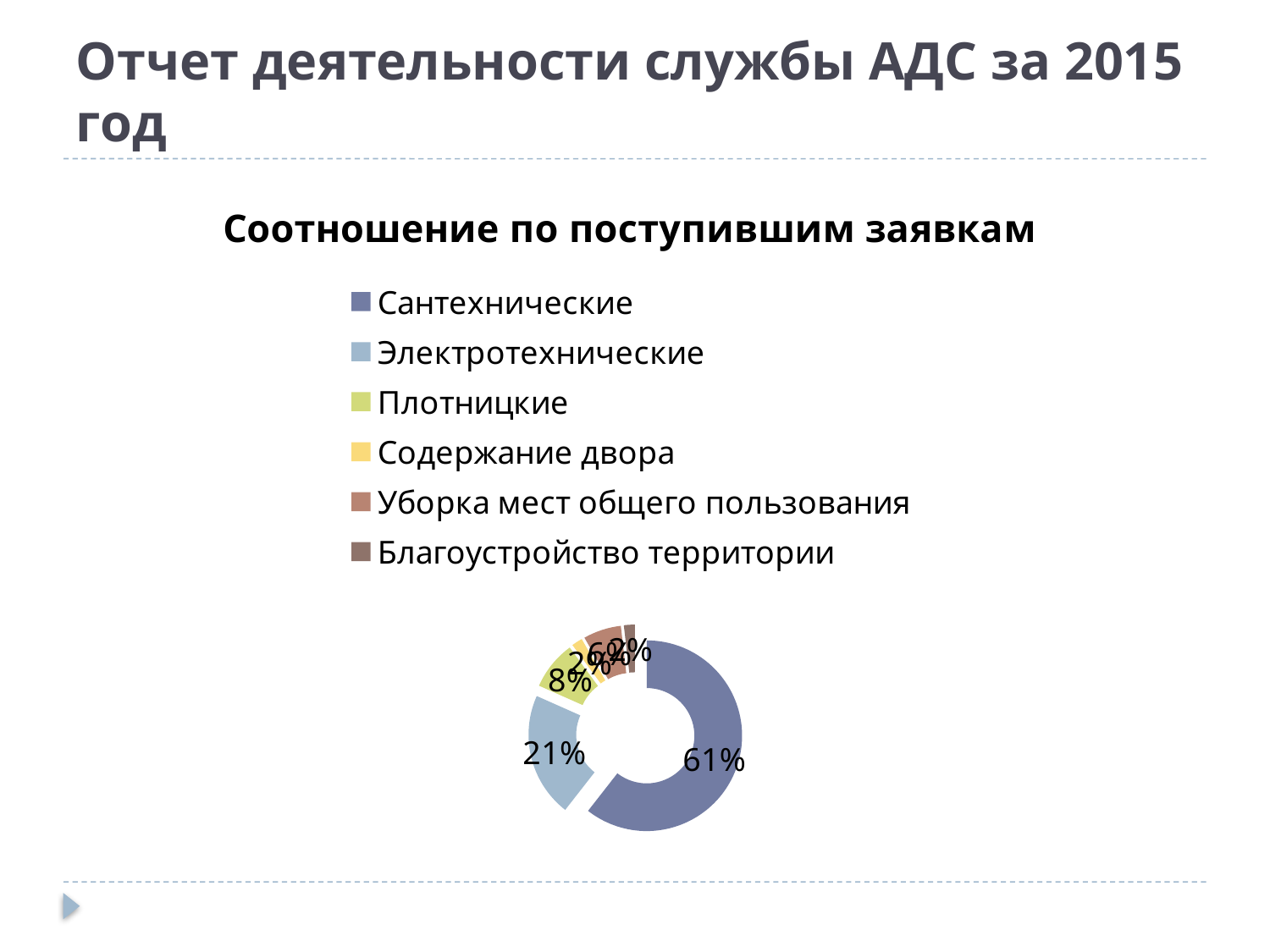
What share of the chart is Сантехнические? 61% Which is larger, the share for Плотницкие or for Электротехнические? Электротехнические What is the difference in percentage points between the shares for Электротехнические and Плотницкие? 13 What is the difference in percentage points between the shares for Сантехнические and Электротехнические? 40 Which category has the largest share of the chart? Сантехнические What share of the chart is Плотницкие? 8% What is the title of the chart? Соотношение по поступившим заявкам What kind of chart is shown on the slide? Doughnut (pie) chart What share of the chart is Электротехнические? 21% How many categories does the chart's legend list? 6 Which legend entry is shown in yellow? Содержание двора Which is larger, the share for Сантехнические or for Электротехнические? Сантехнические